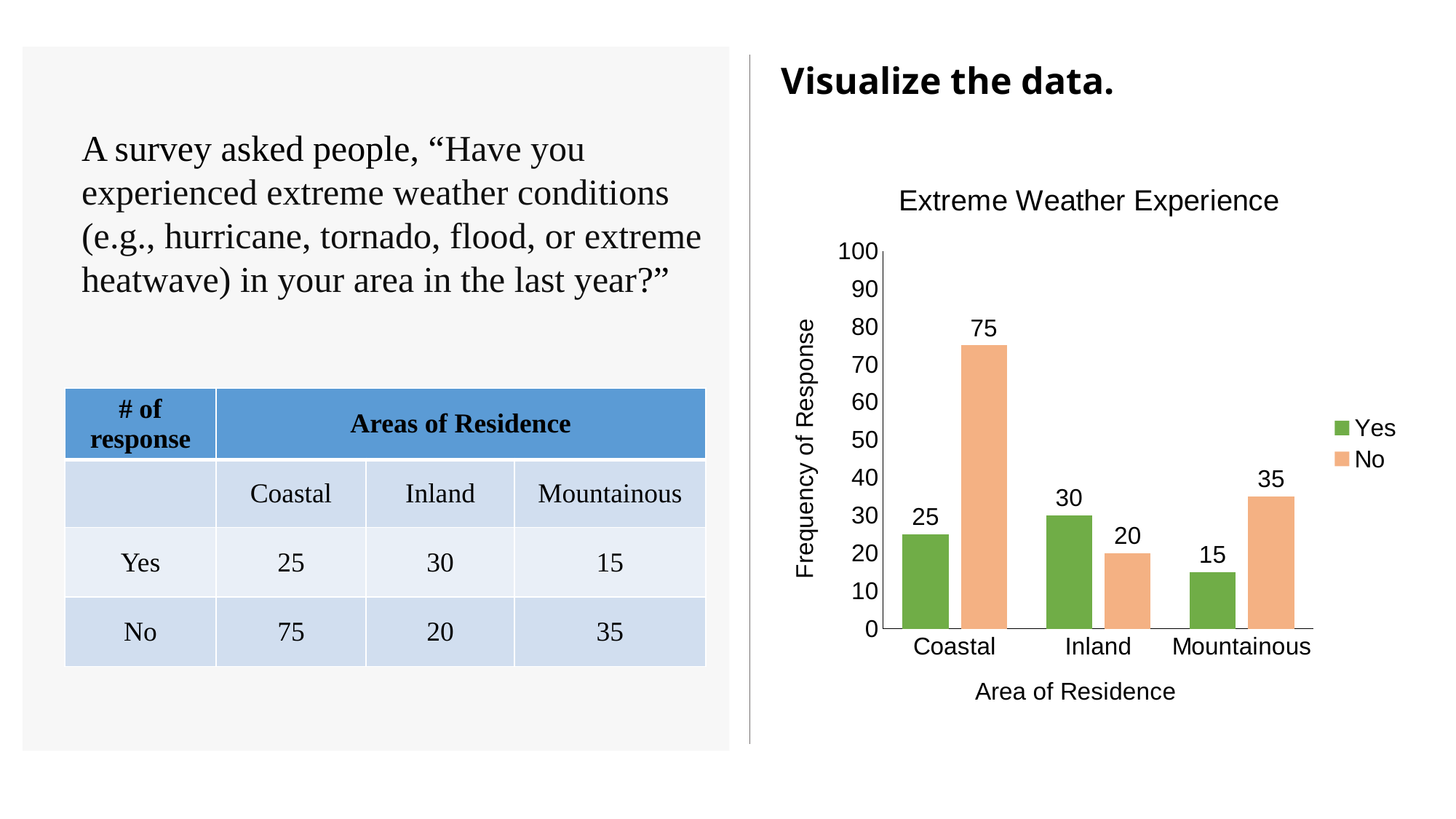
Which is larger for Inland, the Yes value or the No value? Yes What is the difference between the No and Yes values for Coastal? 50 Which area has the highest No value? Coastal What is the value for No in the Inland area? 20 What is the title of the chart? Extreme Weather Experience What is the value for No in the Mountainous area? 35 What kind of chart is shown? bar chart Which area has the lowest Yes value? Mountainous How many areas of residence are shown on the x axis? 3 What is the value for Yes in the Coastal area? 25 Is the No value for Coastal greater or less than 70? greater How many series does the legend list? 2